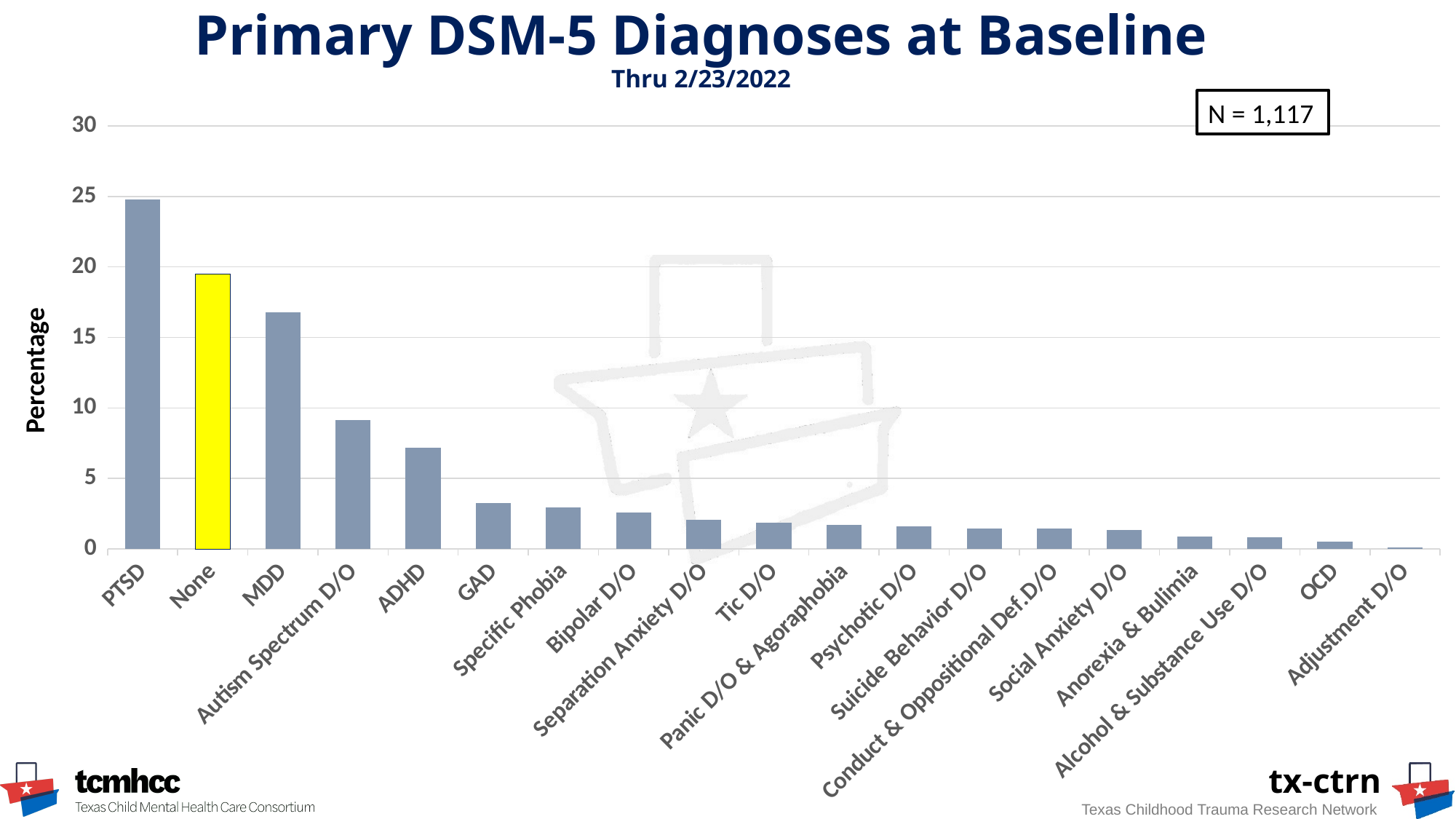
How many diagnosis categories are shown on the x axis? 19 Which diagnosis category has the highest percentage? PTSD Is the percentage for ADHD greater or less than 5? greater Is the percentage for None greater or less than 20? less Which bar is highlighted in yellow? None Which diagnosis category has the lowest percentage? Adjustment D/O Is the percentage for MDD greater or less than 15? greater What kind of chart is shown on the slide? bar chart Which has a higher percentage, MDD or ADHD? MDD Do the percentages generally rise or fall moving from left to right along the x axis? fall